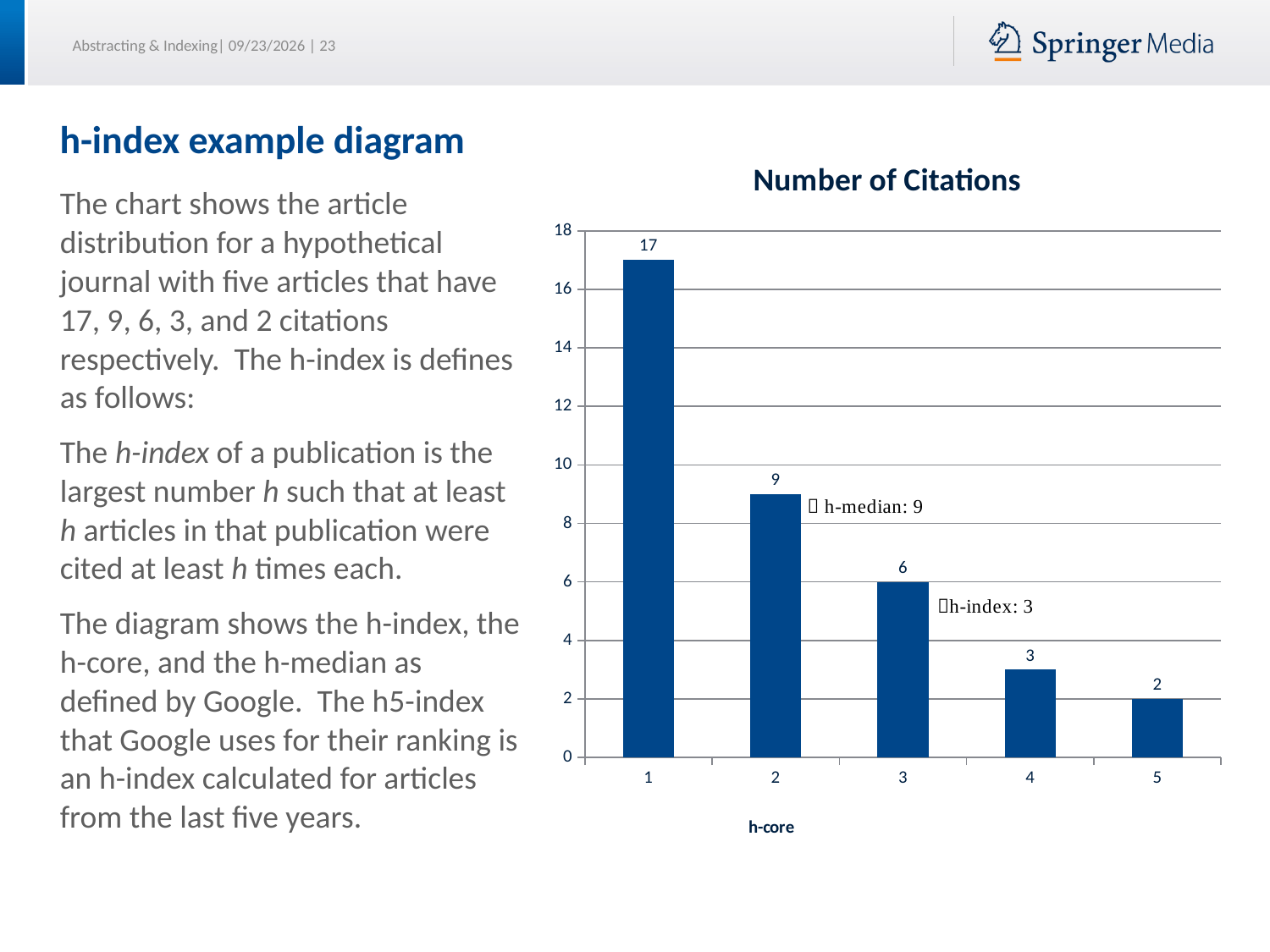
What is the number of citations for article 5? 2 Do the citation values rise or fall from article 1 to article 5? fall Which article has the lowest number of citations? 5 What kind of chart is shown on the slide? bar chart What is the number of citations for article 3? 6 What is the number of citations for article 1? 17 What is the difference in citations between article 3 and article 4? 3 Which article has the highest number of citations? 1 How many articles (bars) are shown in the chart? 5 What is the title of the chart? Number of Citations Which has more citations, article 2 or article 4? 2 What is the difference in citations between article 1 and article 2? 8